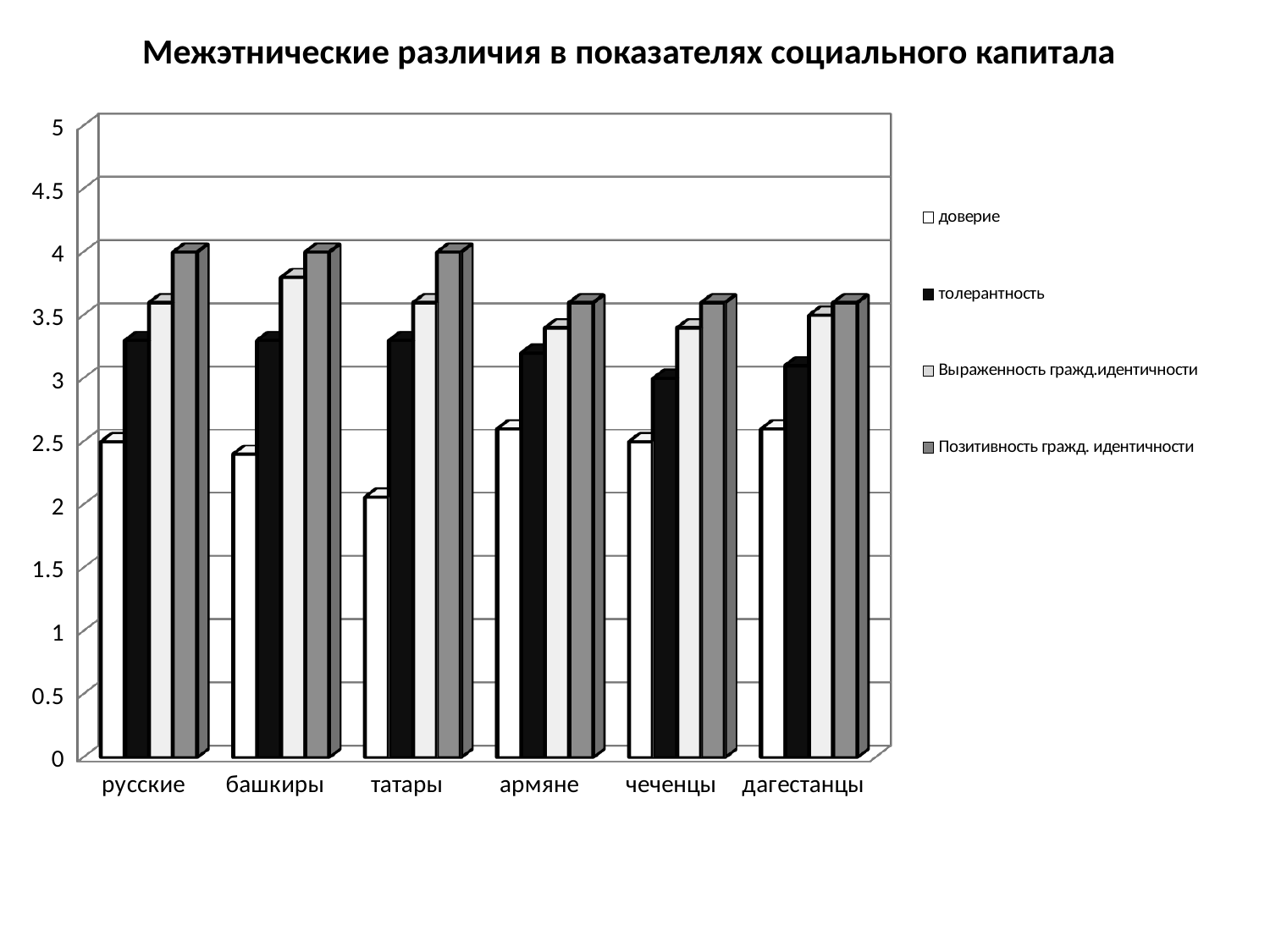
What is the title of the chart? Межэтнические различия в показателях социального капитала How many series does the legend list? 4 How many ethnic groups (categories) are shown on the x axis? 6 Is the value of доверие for татары greater or less than 2.5? less Which ethnic group has the highest value for Выраженность гражд.идентичности? башкиры Which ethnic group has the lowest value for доверие? татары For русские, which is larger: доверие or толерантность? толерантность What kind of chart is shown on the slide? bar chart Is the value of толерантность for чеченцы greater or less than 3.5? less Which is larger: Позитивность гражд. идентичности for русские or for армяне? русские Is the value of Позитивность гражд. идентичности for русские greater or less than 3.5? greater Which series is shown with black bars? толерантность